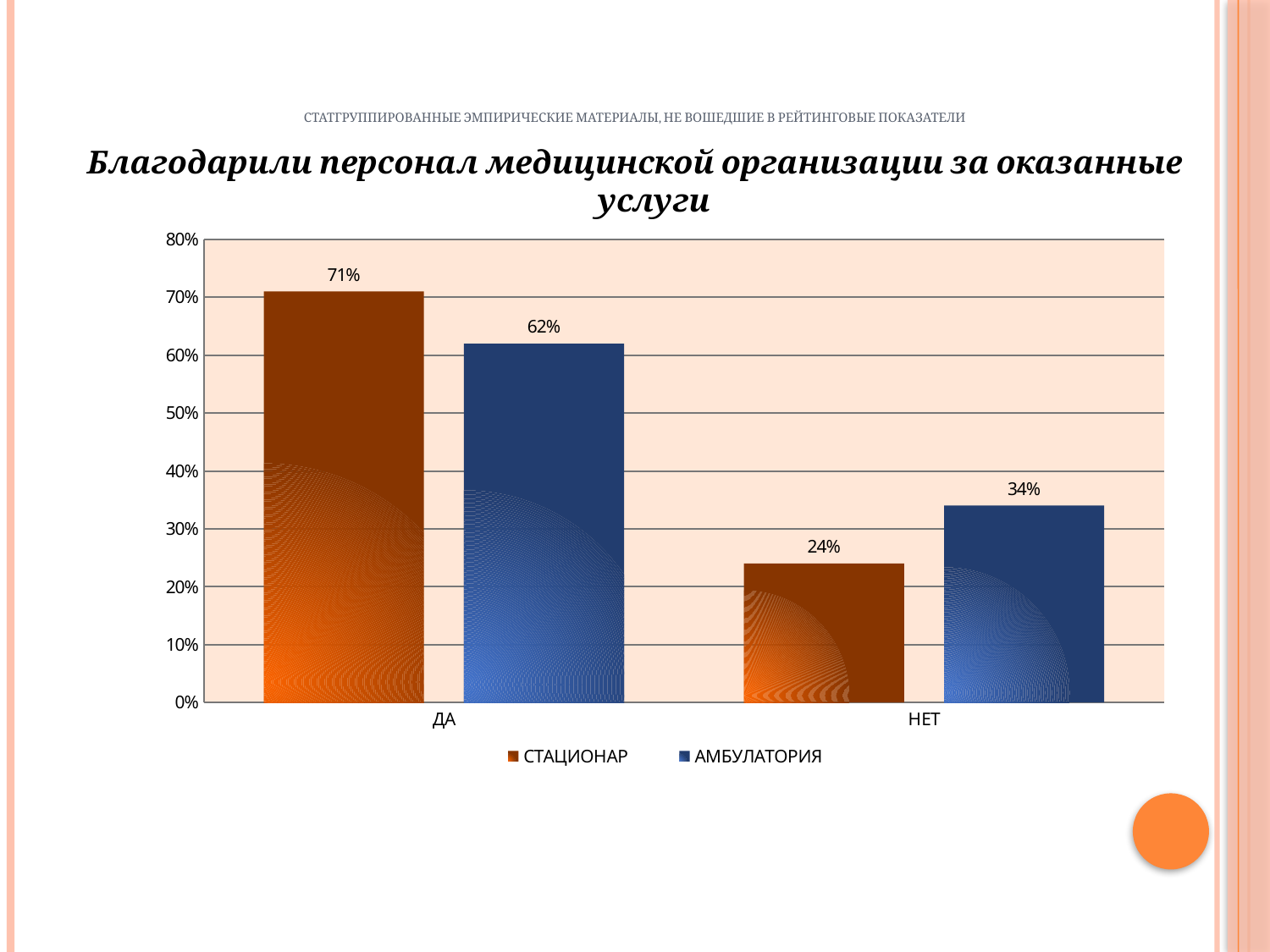
What is the difference between the СТАЦИОНАР and АМБУЛАТОРИЯ values in the ДА category? 9% What is the value for АМБУЛАТОРИЯ in the ДА category? 62% Which series has the highest value in the ДА category? СТАЦИОНАР What is the value for АМБУЛАТОРИЯ in the НЕТ category? 34% How many series does the legend list? 2 What is the value for СТАЦИОНАР in the ДА category? 71% How many categories are shown on the x axis? 2 Which is larger: АМБУЛАТОРИЯ for ДА or АМБУЛАТОРИЯ for НЕТ? АМБУЛАТОРИЯ for ДА What is the value for СТАЦИОНАР in the НЕТ category? 24% What kind of chart is shown on the slide? Bar chart Which series has the lowest value in the НЕТ category? СТАЦИОНАР What is the difference between the АМБУЛАТОРИЯ and СТАЦИОНАР values in the НЕТ category? 10%